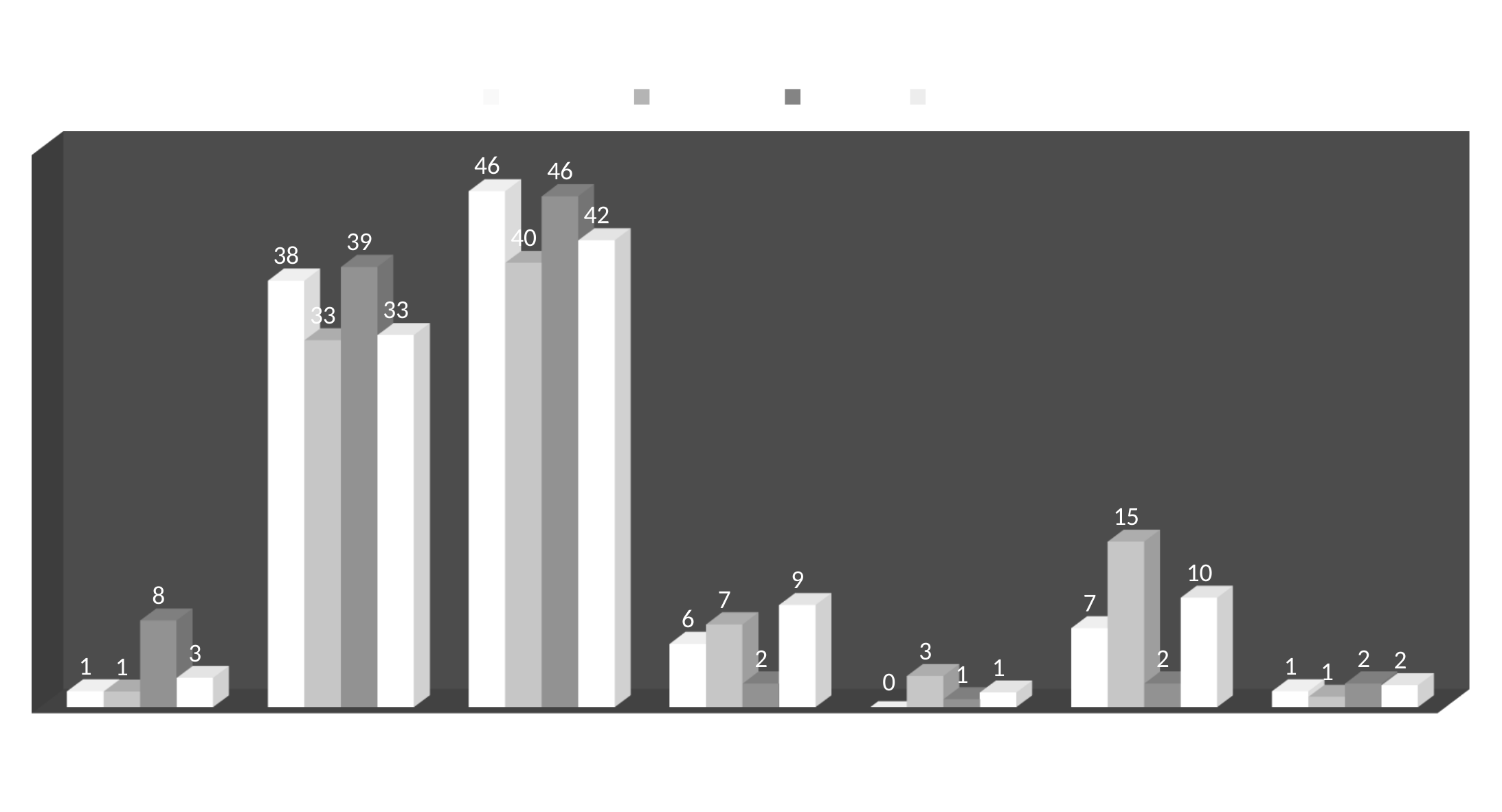
How many series does the legend list? 4 In the sixth group of bars from the left, which is larger: the second bar or the fourth bar? the second bar (15) In the sixth group of bars from the left, what is the value of the second bar? 15 What kind of chart is shown on the slide? bar chart In the third group of bars from the left, what is the difference between the first bar and the second bar? 6 In the third group of bars from the left, what is the value of the fourth (rightmost) bar? 42 What is the total of the four values in the first group of bars from the left? 13 In the fifth group of bars from the left, what is the value of the first (leftmost) bar? 0 What is the highest value labelled anywhere on the chart? 46 In the second group of bars from the left, which bar has the highest value? the third bar (39) How many groups of bars are plotted along the x axis? 7 In the fourth group of bars from the left, which bar has the lowest value? the third bar (2)